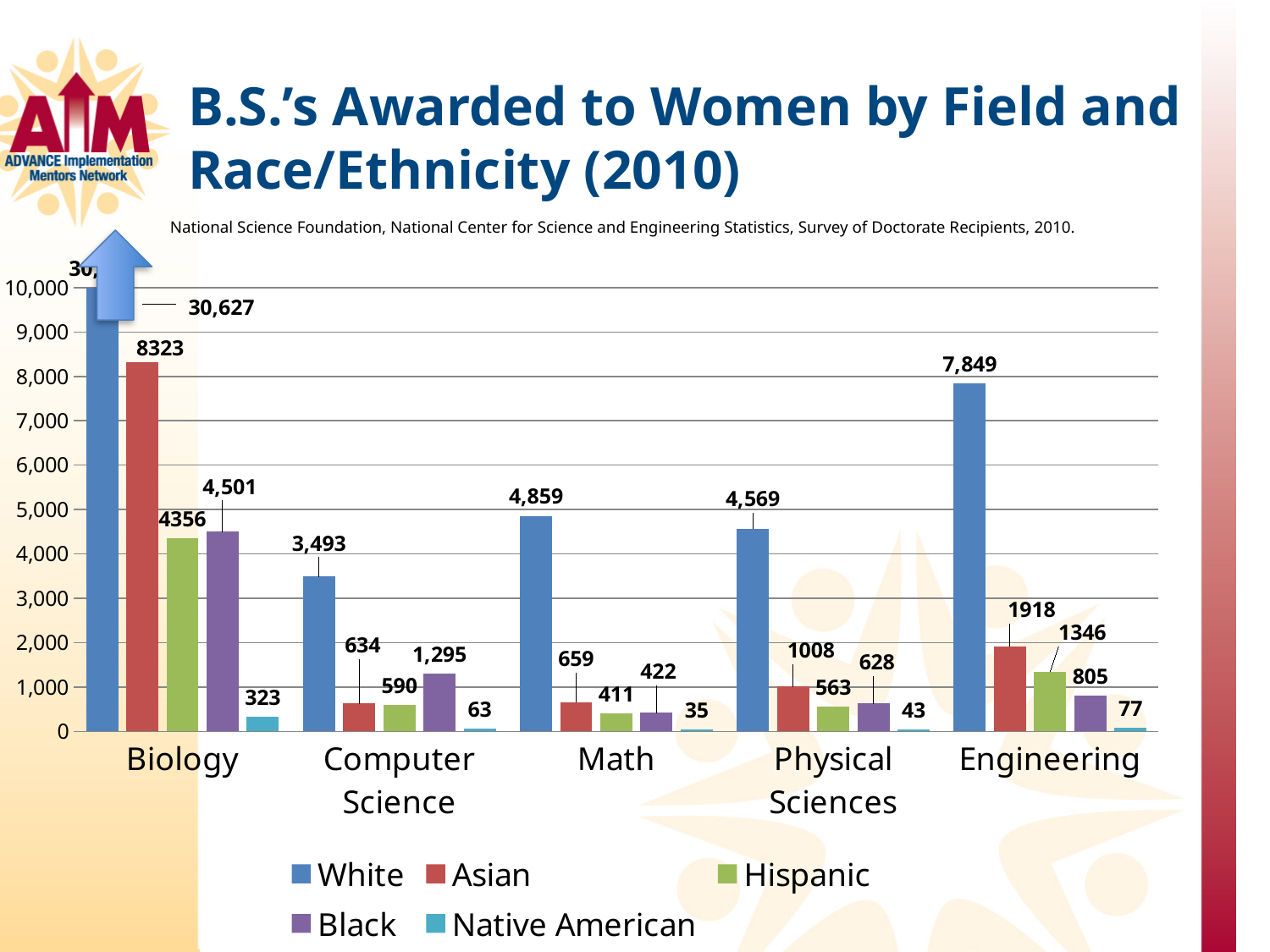
What is the difference between the White value for Math and the White value for Physical Sciences? 290 Which field has the highest value for White? Biology How many fields are shown on the x axis? 5 Which is larger in Engineering, the Asian value or the Hispanic value? Asian Is the value for White in Computer Science greater or less than 3,000? greater What is the value for Black in Computer Science? 1,295 What is the value for Asian in Biology? 8323 What kind of chart is shown on the slide? bar chart How many series does the legend list? 5 Which field has the lowest value for Native American? Math What is the value for Native American in Math? 35 What is the value for White in Engineering? 7,849